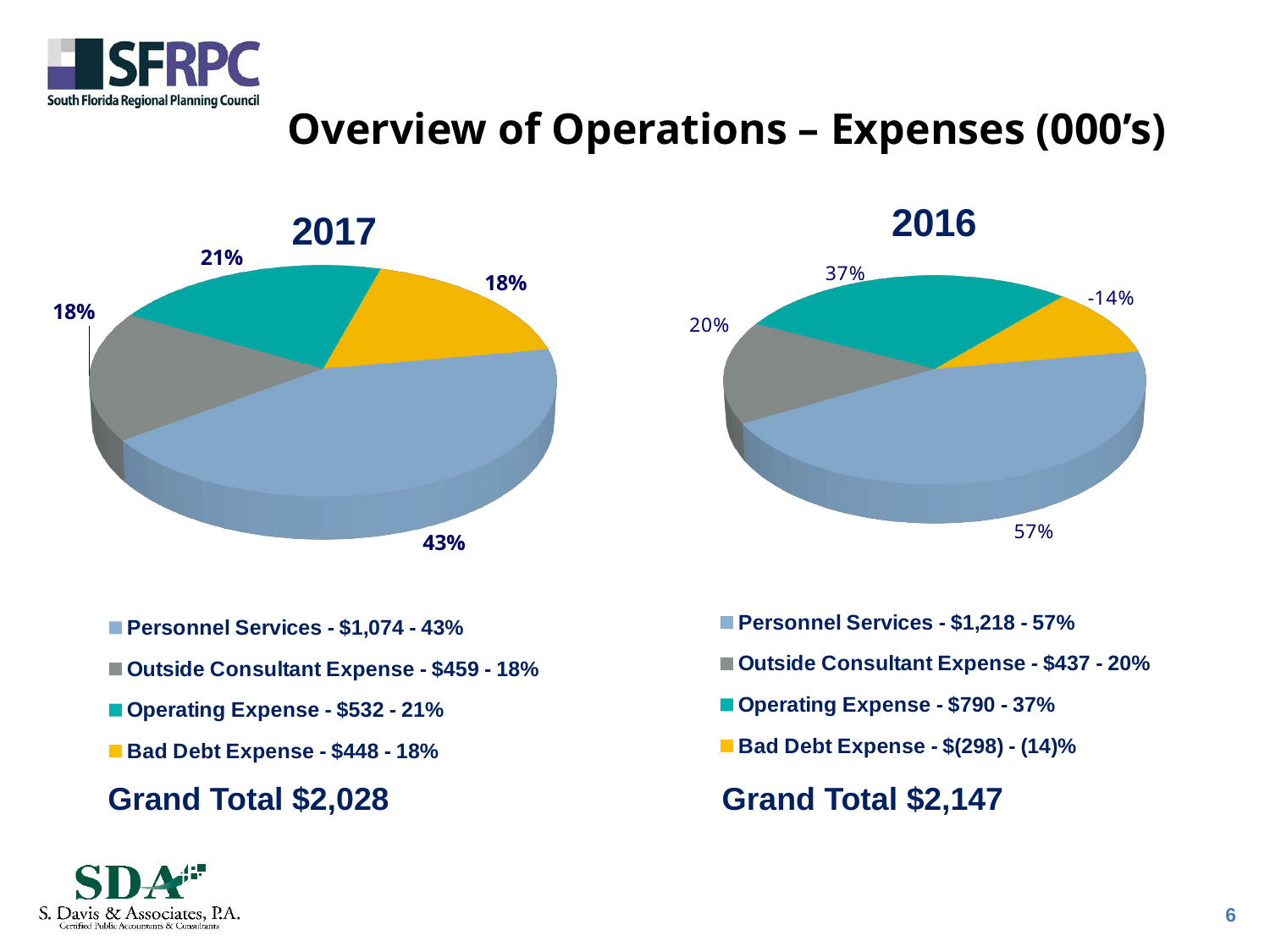
In the 2017 chart, what share of the pie is Personnel Services? 43% How many entries does the legend of the 2016 chart list? 4 In the 2017 chart, what is the value for Operating Expense? $532 How many categories does the 2017 chart show? 4 In the 2017 chart, which category has the largest slice? Personnel Services In the 2016 chart, what is the value for Outside Consultant Expense? $437 In the 2017 chart, what is the difference between Personnel Services and Operating Expense? $542 In the 2016 chart, which is larger, Operating Expense or Outside Consultant Expense? Operating Expense What is the grand total shown under the 2016 chart? $2,147 What type of chart is used for the 2017 chart? pie chart In the 2016 chart, which category has the smallest value? Bad Debt Expense In the 2016 chart, what share of the pie is Operating Expense? 37%